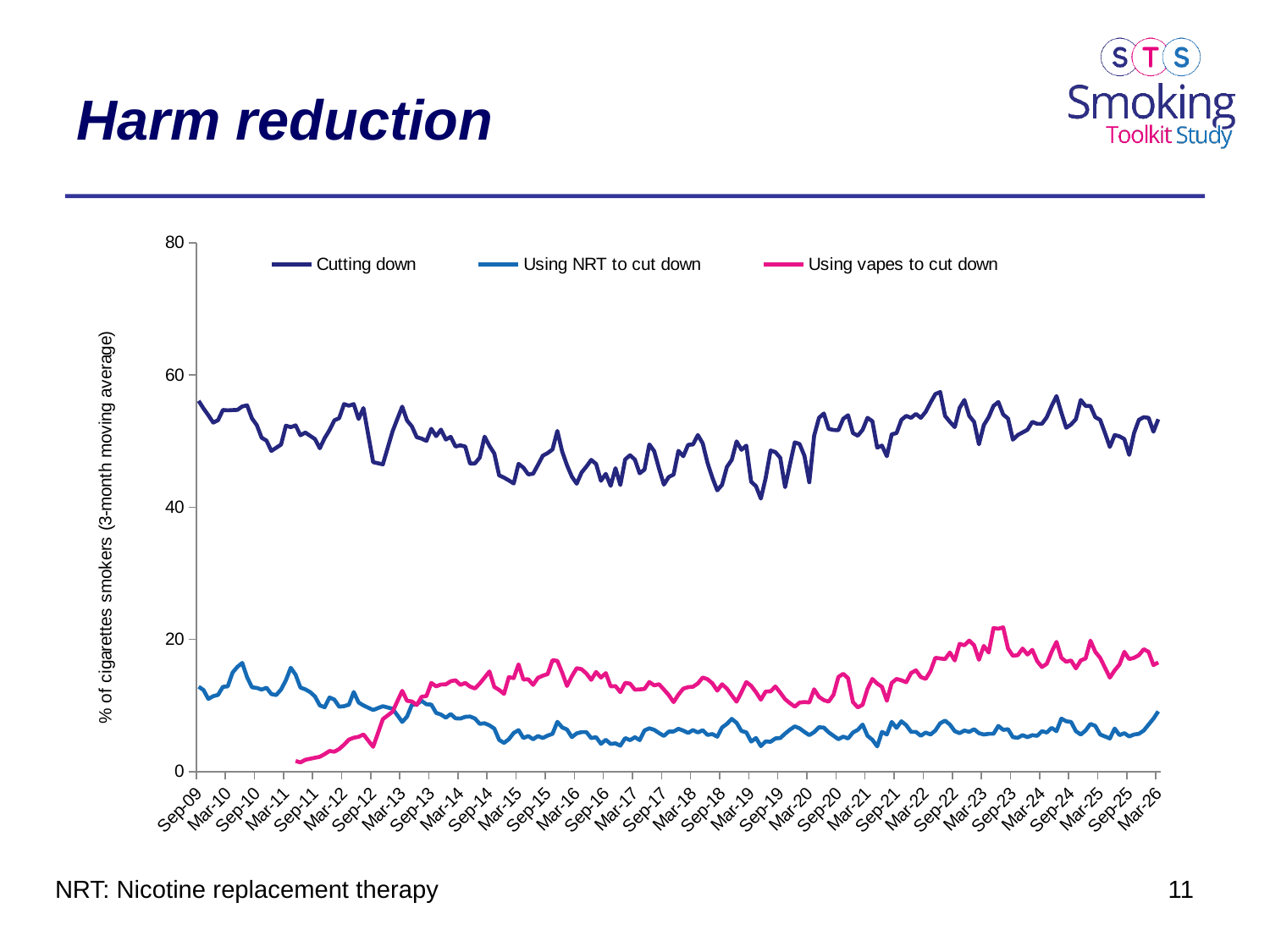
Overall, does the Using vapes to cut down series rise or fall from Sep-11 to Mar-26? Rise At Mar-26, which series has the larger value: Cutting down or Using vapes to cut down? Cutting down Is the value for Cutting down at Mar-26 greater or less than 40? greater Is the value for Cutting down at Sep-09 greater or less than 40? greater At Mar-26, which series has the larger value: Using vapes to cut down or Using NRT to cut down? Using vapes to cut down At Sep-11, which series has the larger value: Using NRT to cut down or Using vapes to cut down? Using NRT to cut down What kind of chart is shown on the slide? Line chart Is the value for Using NRT to cut down at Mar-26 greater or less than 20? less What is the label on the vertical axis of the chart? % of cigarettes smokers (3-month moving average) How many series does the legend list? 3 What is the title of the slide containing the chart? Harm reduction